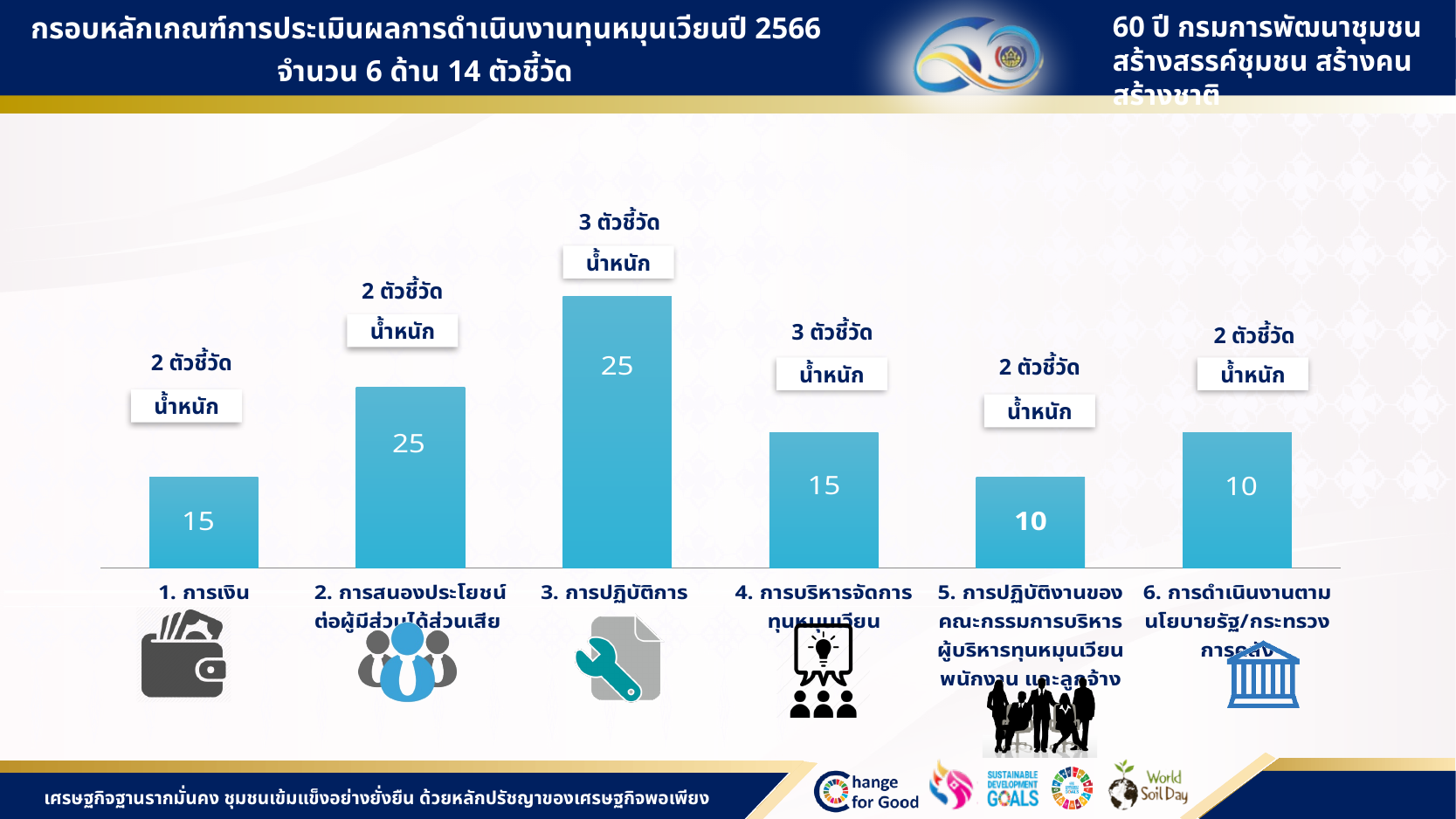
What is the weight value shown for category 3. การปฏิบัติการ? 25 What is the difference between the weight for category 2 and the weight for category 1? 10 Which has a larger weight, category 4. การบริหารจัดการทุนหมุนเวียน or category 5? 4. การบริหารจัดการทุนหมุนเวียน What is the sum of the weight values of all six bars? 100 What is the weight (น้ำหนัก) value shown for category 1. การเงิน? 15 What is the weight value shown for category 4. การบริหารจัดการทุนหมุนเวียน? 15 How many categories (bars) are shown in the chart? 6 How many indicators (ตัวชี้วัด) are listed above the bar for category 3. การปฏิบัติการ? 3 ตัวชี้วัด What kind of chart is shown on the slide? Bar chart What is the weight value shown for category 6. การดำเนินงานตามนโยบายรัฐ/กระทรวงการคลัง? 10